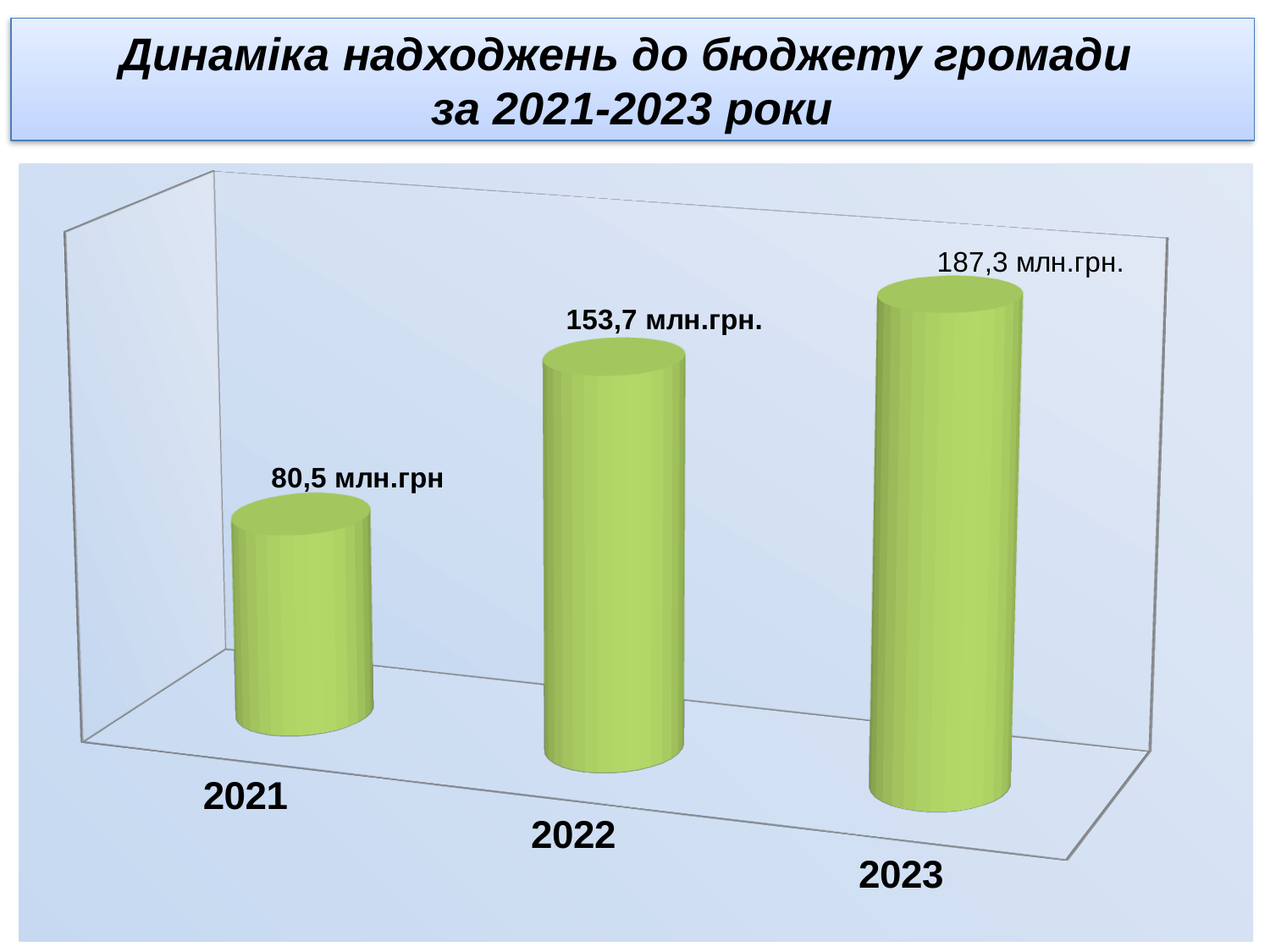
Do the values rise or fall from 2021 to 2023? Rise Which year has the lowest value? 2021 Which year has the highest value? 2023 What is the value shown for 2021? 80,5 млн.грн What is the difference between the values for 2022 and 2021? 73,2 млн.грн. What is the difference between the values for 2023 and 2022? 33,6 млн.грн. What is the value shown for 2023? 187,3 млн.грн. How many years are shown on the chart? 3 What is the title of the chart? Динаміка надходжень до бюджету громади за 2021-2023 роки What is the value shown for 2022? 153,7 млн.грн. What kind of chart is shown on the slide? Bar chart Which is larger, the value for 2021 or the value for 2022? 2022